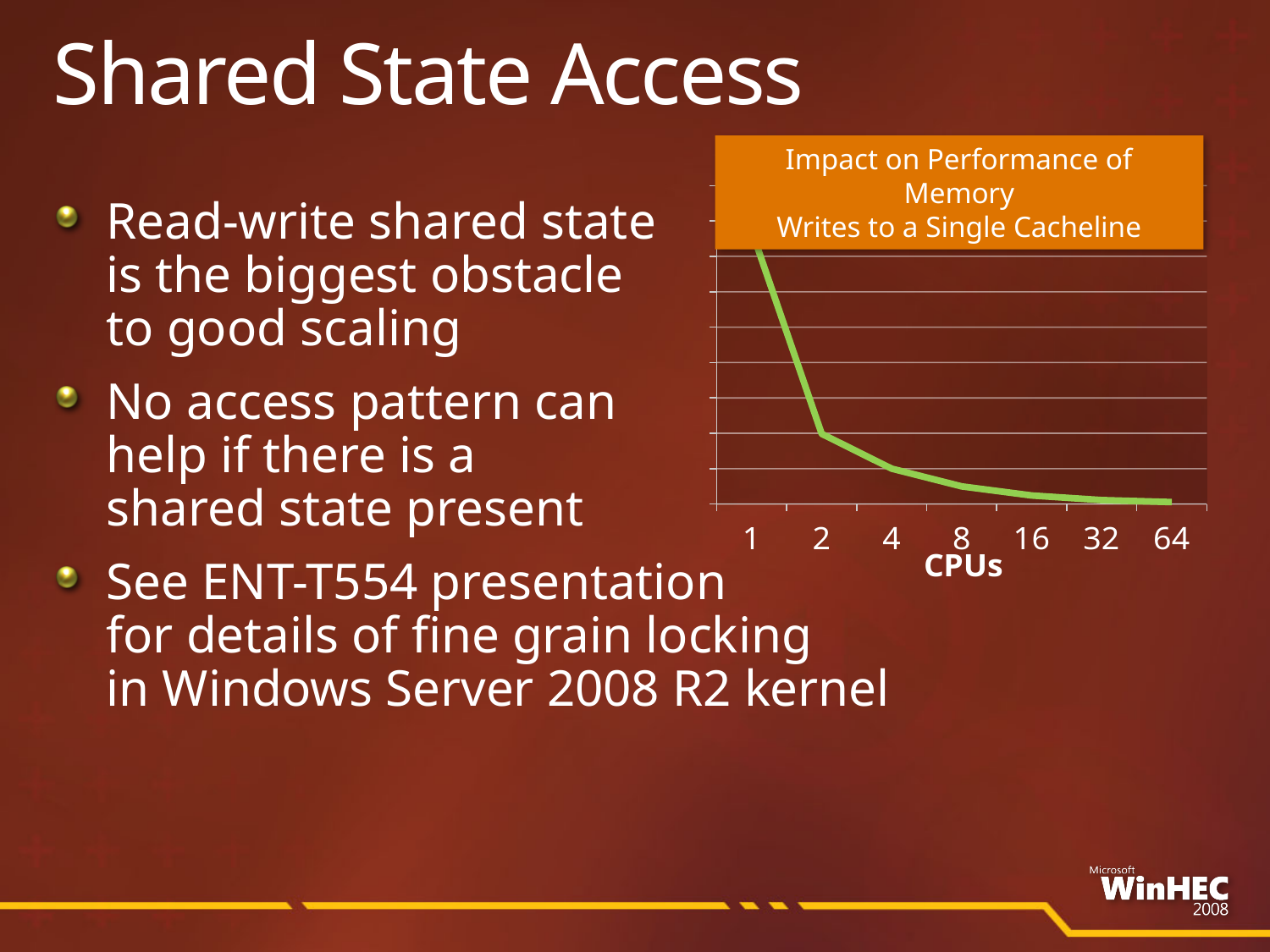
Do the values on the chart rise or fall as the number of CPUs increases? fall How many CPU counts are marked along the x axis of the chart? 7 Which has the larger plotted value, 1 CPU or 8 CPUs? 1 CPU What kind of chart is shown on the slide? line chart What is the first CPU count shown on the x axis of the chart? 1 At which number of CPUs is the plotted value highest? 1 What is the last CPU count shown on the x axis of the chart? 64 Which has the larger plotted value, 2 CPUs or 32 CPUs? 2 CPUs What is the title of the chart? Impact on Performance of Memory Writes to a Single Cacheline What is the label of the x axis of the chart? CPUs Which has the smaller plotted value, 4 CPUs or 1 CPU? 4 CPUs